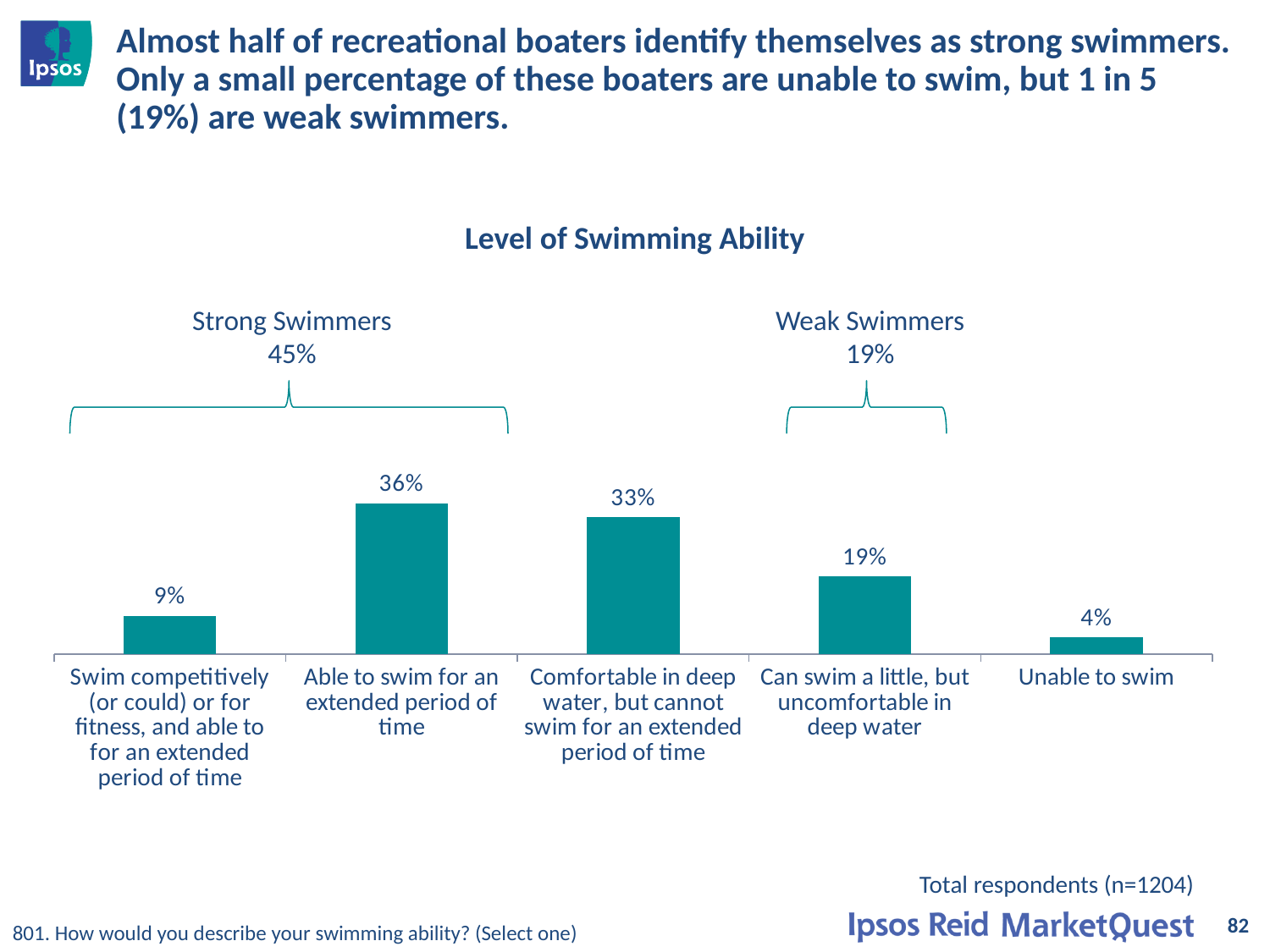
What kind of chart is shown on the slide? Bar chart What percentage is labelled as "Strong Swimmers" above the bracket? 45% Which category has the lowest value? Unable to swim What is the value for "Swim competitively (or could) or for fitness, and able to for an extended period of time"? 9% What is the title of the chart? Level of Swimming Ability What is the value for "Able to swim for an extended period of time"? 36% Which category has the highest value? Able to swim for an extended period of time Which is larger: "Can swim a little, but uncomfortable in deep water" or "Swim competitively (or could) or for fitness, and able to for an extended period of time"? Can swim a little, but uncomfortable in deep water What is the difference between "Able to swim for an extended period of time" and "Comfortable in deep water, but cannot swim for an extended period of time"? 3% What is the value for "Unable to swim"? 4% How many categories are shown in the chart? 5 What is the value for "Can swim a little, but uncomfortable in deep water"? 19%